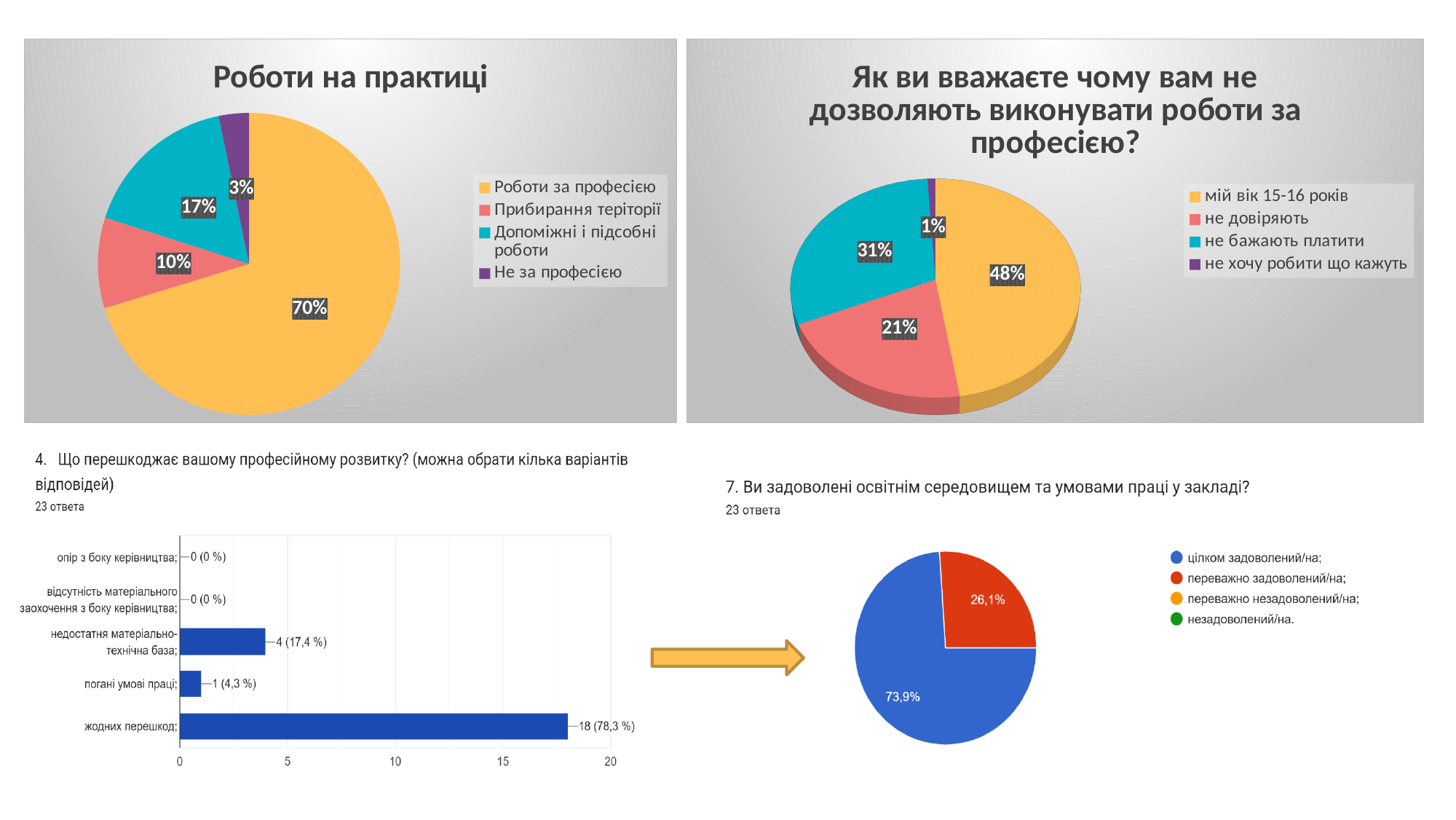
How many entries does the legend of the bottom-right pie chart for question 7 list? 4 In the bottom-right pie chart for question 7, what share is shown for 'переважно задоволений/на'? 26,1% In the bottom-left bar chart for question 4, what value is shown for 'жодних перешкод'? 18 (78,3 %) How many categories does the legend of the 'Роботи на практиці' pie chart list? 4 What kind of chart is used for question 4 'Що перешкоджає вашому професійному розвитку?' at the bottom left? Bar chart In the bottom-left bar chart for question 4, what value is shown for 'недостатня матеріально-технічна база'? 4 (17,4 %) In the top-right pie chart 'Як ви вважаєте чому вам не дозволяють виконувати роботи за професією?', what share is shown for 'не бажають платити'? 31% In the 'Роботи на практиці' pie chart, which category has the smallest slice? Не за професією In the 'Роботи на практиці' pie chart, what is the difference between the shares for 'Допоміжні і підсобні роботи' and 'Прибирання теріторії'? 7% In the top-right pie chart, which is larger: the share for 'не довіряють' or the share for 'не хочу робити що кажуть'? не довіряють In the top-right pie chart 'Як ви вважаєте чому вам не дозволяють виконувати роботи за професією?', which category has the largest slice? мій вік 15-16 років In the 'Роботи на практиці' pie chart, what share is shown for 'Роботи за професією'? 70%